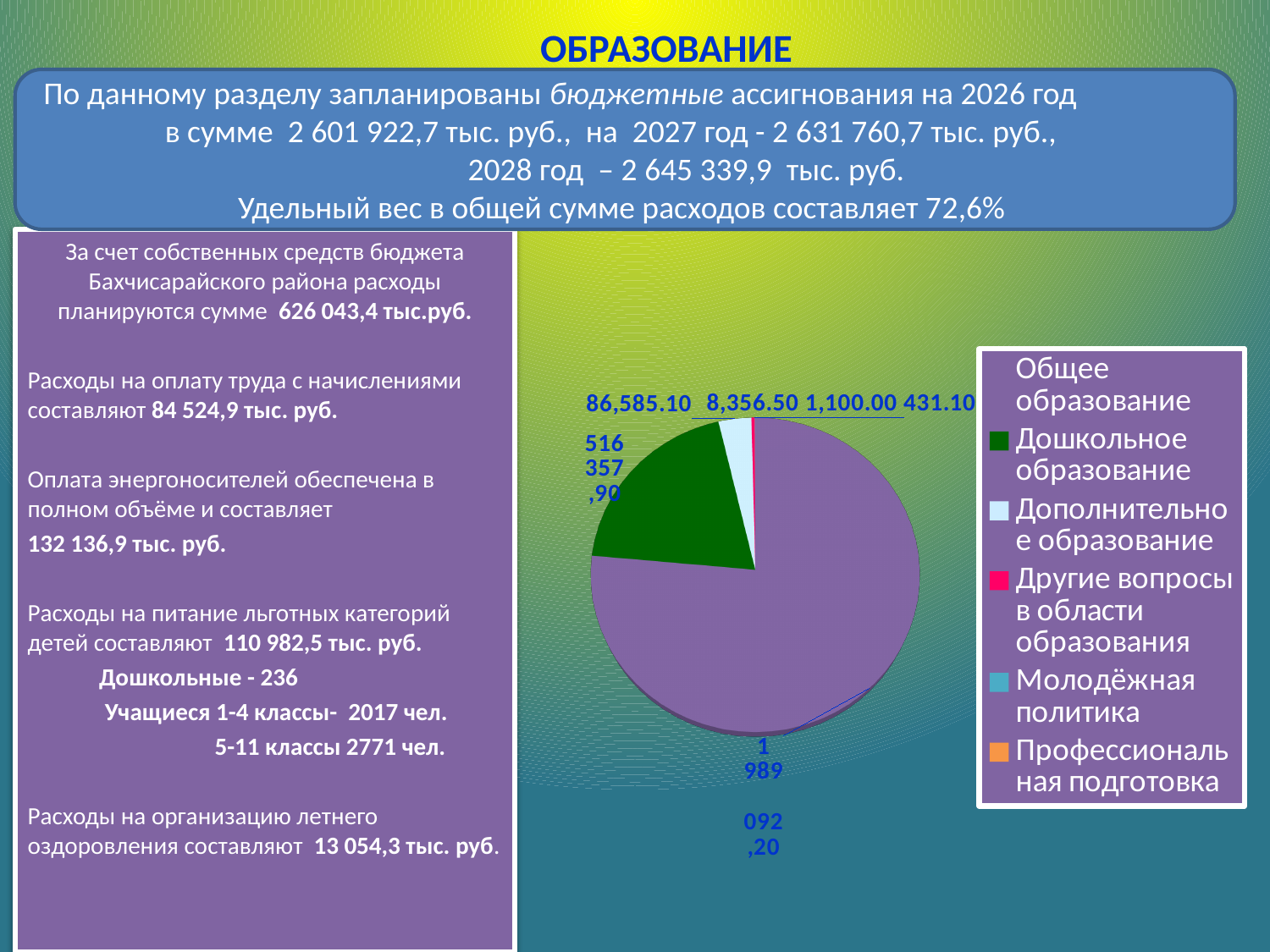
What colour is the slice for Дошкольное образование in the pie chart? green What value is shown for Дополнительное образование in the pie chart? 86,585.10 How many categories does the legend of the pie chart list? 6 What kind of chart is shown on the slide? pie chart What colour is the slice for Общее образование in the pie chart? purple What value is shown for Профессиональная подготовка in the pie chart? 431.10 Which category has the smallest slice in the pie chart? Профессиональная подготовка What value is shown for Другие вопросы в области образования in the pie chart? 8,356.50 What value is shown for Молодёжная политика in the pie chart? 1,100.00 Which is larger in the pie chart: Дошкольное образование or Дополнительное образование? Дошкольное образование Which category has the largest slice in the pie chart? Общее образование What value is shown for Дошкольное образование in the pie chart? 516 357,90